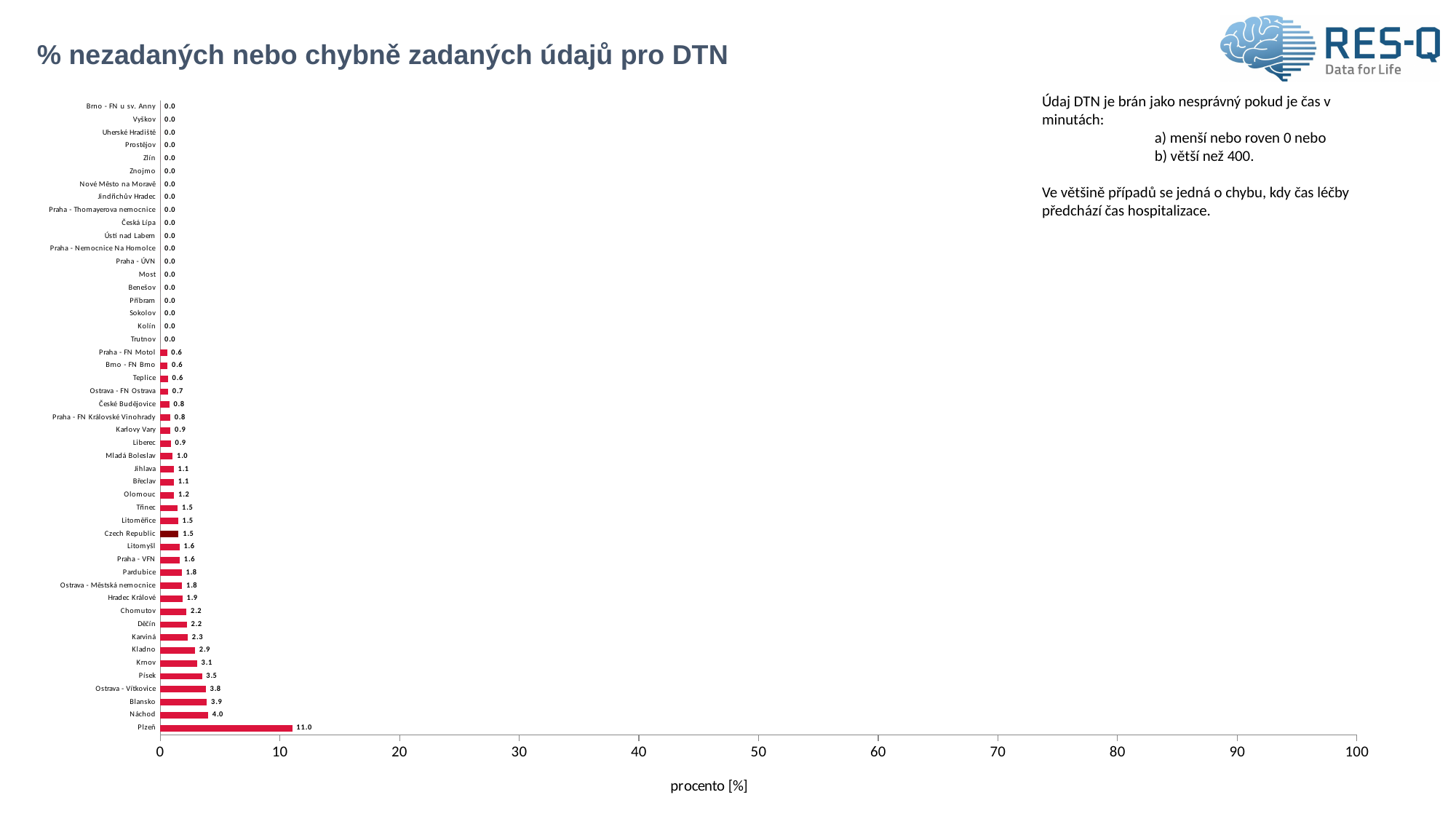
What is the value for Kladno? 2.9 What is the value for Náchod? 4.0 What is the value for Czech Republic? 1.5 What is the difference between the values for Plzeň and Náchod? 7.0 Is the value for Plzeň greater or less than 10? greater What is the difference between the values for Blansko and Krnov? 0.8 Which category has the highest value? Plzeň What is the label of the horizontal axis? procento [%] Which has a larger value, Písek or Ostrava - Vítkovice? Ostrava - Vítkovice What is the value for Hradec Králové? 1.9 What is the value for Plzeň? 11.0 What kind of chart is shown on the slide? bar chart